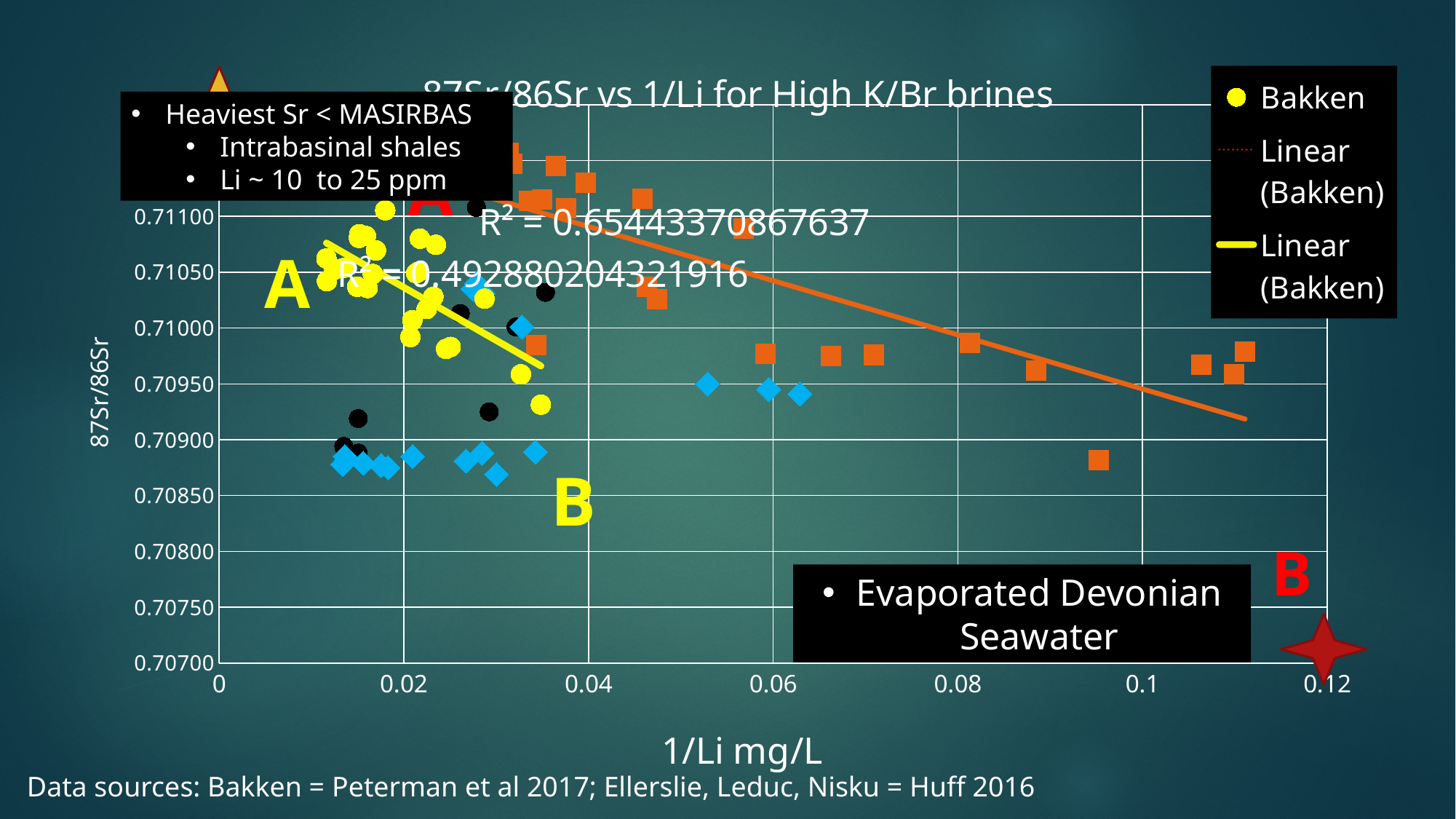
What kind of chart is shown on the slide? Scatter chart What is the lower R² value printed on the chart? R² = 0.492880204321916 What is the maximum value shown on the y axis? 0.71100 What is the title of the chart? 87Sr/86Sr vs 1/Li for High K/Br brines What is the higher R² value printed on the chart? R² = 0.65443370867637 How many entries does the chart legend list? 3 Do the fitted linear trend lines rise or fall as 1/Li increases along the x axis? Fall What is the maximum value shown on the x axis? 0.12 What is the minimum value shown on the y axis? 0.70700 What is the label of the x axis? 1/Li mg/L Is the y value of the orange square point near x = 0.095 greater or less than 0.70900? less Which of the two printed R² values is larger, 0.65443370867637 or 0.492880204321916? 0.65443370867637